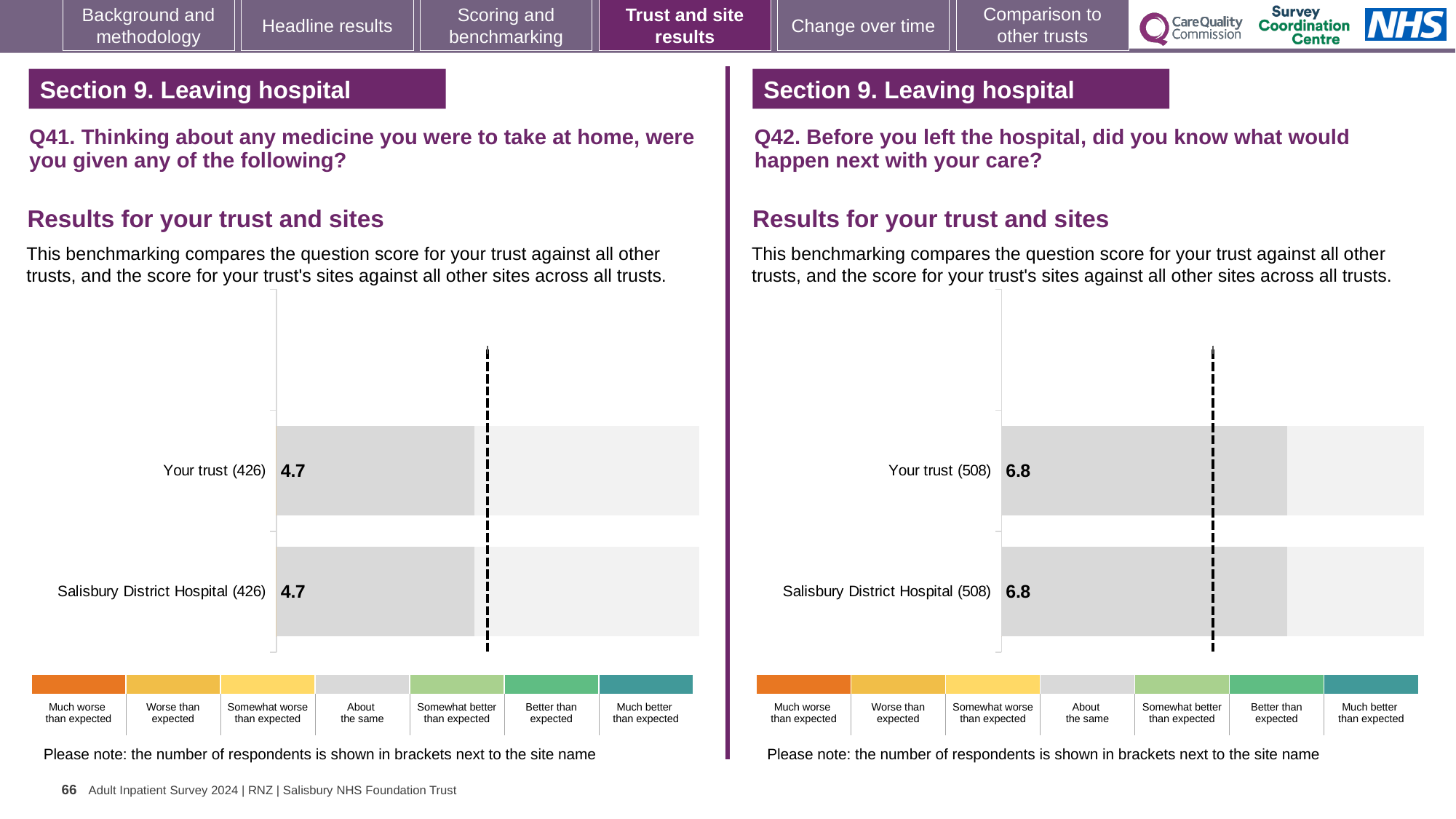
What kind of chart is used for the Q42 results on the right? Bar chart In the Q41 chart on the left, what is the difference between the score for Your trust and the score for Salisbury District Hospital? 0 How many bars are plotted in the Q42 chart on the right? 2 In the Q41 chart on the left, what is the score for Salisbury District Hospital? 4.7 In the Q41 chart on the left, what is the score for Your trust? 4.7 How many bars are plotted in the Q41 chart on the left? 2 In the Q41 chart on the left, how many respondents are shown in brackets for Your trust? 426 In the Q42 chart on the right, what is the score for Salisbury District Hospital? 6.8 How many rating bands does the colour key below the Q41 chart on the left list? 7 In the Q42 chart on the right, how many respondents are shown in brackets for Salisbury District Hospital? 508 In the Q42 chart on the right, what is the score for Your trust? 6.8 In the Q42 chart on the right, what is the difference between the score for Your trust and the score for Salisbury District Hospital? 0